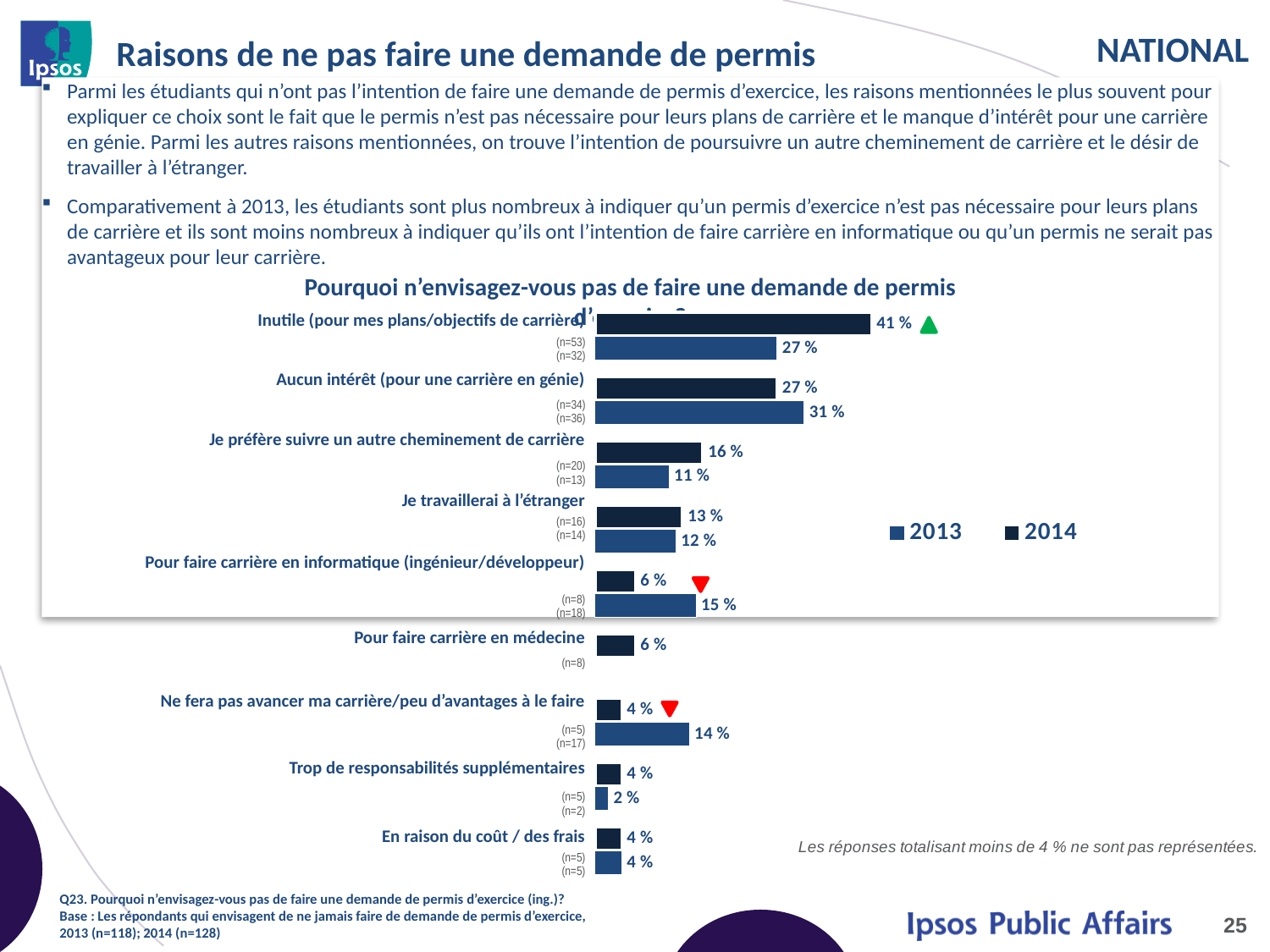
How many categories are shown on the chart? 9 How many series does the chart legend list? 2 What is the 2013 value for "Pour faire carrière en informatique (ingénieur/développeur)"? 15 % For "Je préfère suivre un autre cheminement de carrière", which year has the larger value, 2013 or 2014? 2014 Which category has the highest 2014 value? Inutile (pour mes plans/objectifs de carrière) Which category has the lowest 2013 value? Trop de responsabilités supplémentaires Which series is shown in the darker navy colour in the legend? 2014 What is the 2013 value for "Aucun intérêt (pour une carrière en génie)"? 31 % What type of chart is shown on the slide? bar chart What is the 2014 value for "Inutile (pour mes plans/objectifs de carrière)"? 41 % What is the difference between the 2014 and 2013 values for "Inutile (pour mes plans/objectifs de carrière)"? 14 % What is the difference between the 2013 and 2014 values for "Ne fera pas avancer ma carrière/peu d'avantages à le faire"? 10 %